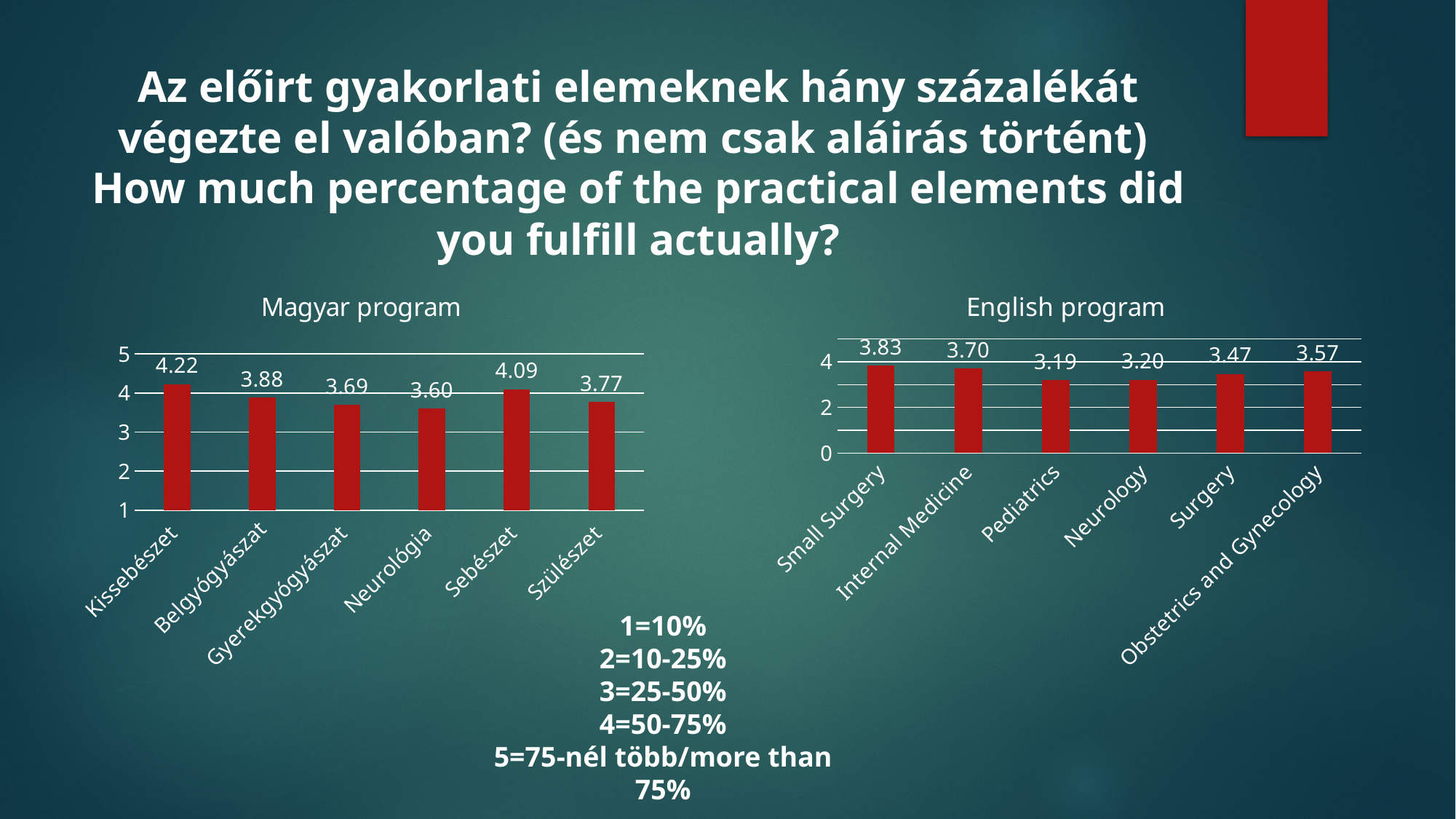
In the English program chart, which is larger, the value for Surgery or the value for Obstetrics and Gynecology? Obstetrics and Gynecology In the English program chart, what is the difference between the values for Small Surgery and Pediatrics? 0.64 In the Magyar program chart, what is the value for Kissebészet? 4.22 In the Magyar program chart, which category has the lowest value? Neurológia In the Magyar program chart, what is the difference between the values for Kissebészet and Neurológia? 0.62 In the English program chart, what is the value for Internal Medicine? 3.70 In the English program chart, which category has the lowest value? Pediatrics What kind of chart is the English program chart? Bar chart In the Magyar program chart, is the value for Sebészet greater or less than 4? greater In the Magyar program chart, how many categories are shown? 6 In the Magyar program chart, which category has the highest value? Kissebészet In the English program chart, which category has the highest value? Small Surgery